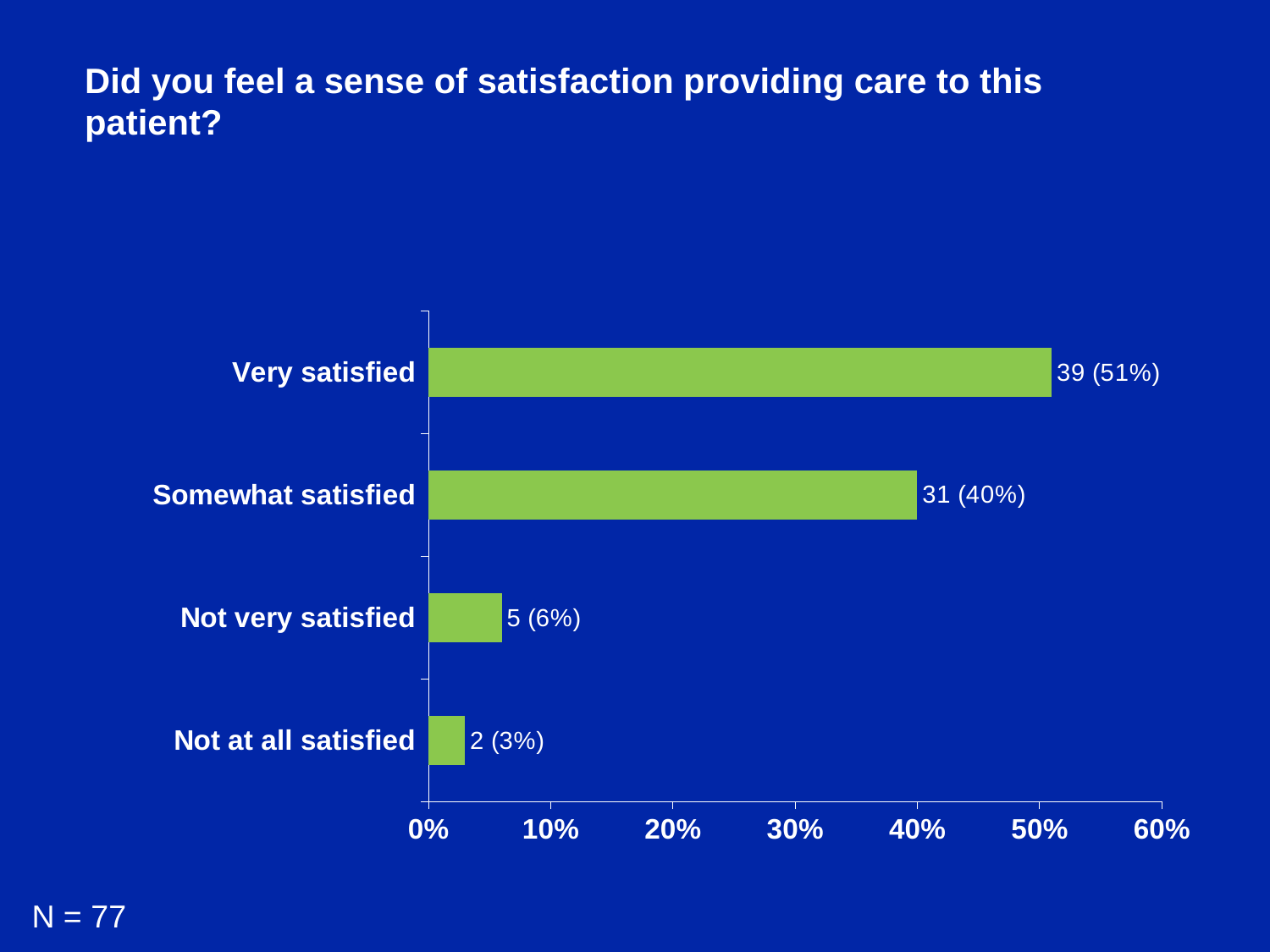
How many categories are shown in the chart? 4 What kind of chart is shown on the slide? bar chart Is the value for Somewhat satisfied greater or less than 30%? greater What is the data label for Somewhat satisfied? 31 (40%) What is the data label for Not at all satisfied? 2 (3%) Which category has the highest value? Very satisfied How many more respondents were Very satisfied than Somewhat satisfied? 8 What is the data label for Not very satisfied? 5 (6%) What is the sample size (N) shown on the slide? 77 Which category has the lowest value? Not at all satisfied Which is larger, the value for Not very satisfied or Not at all satisfied? Not very satisfied What is the data label for Very satisfied? 39 (51%)